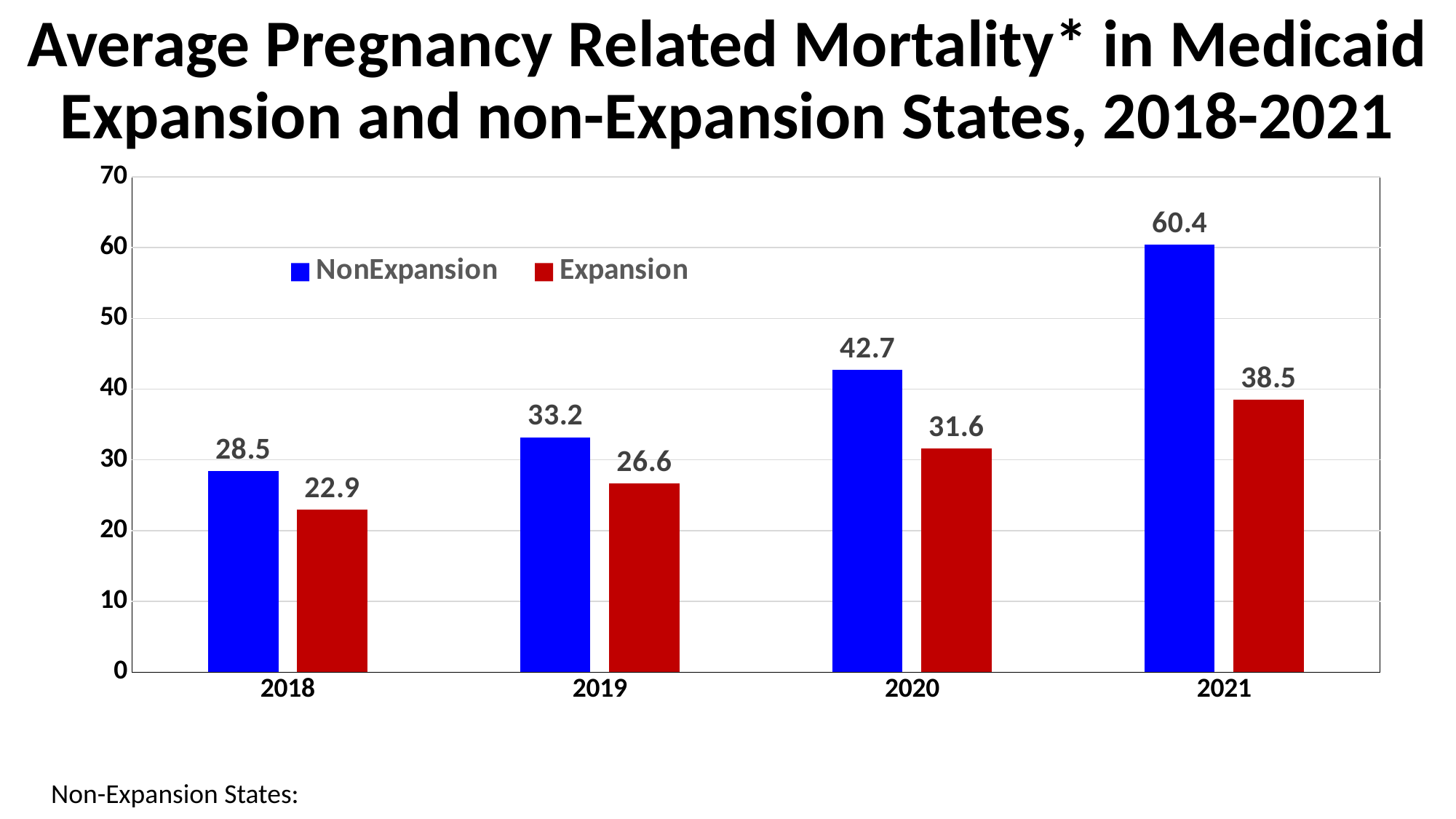
Do the Expansion values rise or fall from 2018 to 2021? Rise What is the Expansion value for 2020? 31.6 What is the Expansion value for 2018? 22.9 What is the NonExpansion value for 2021? 60.4 How many years are shown on the x axis? 4 Which year has the highest NonExpansion value? 2021 Which year has the lowest Expansion value? 2018 What is the difference between the NonExpansion values for 2020 and 2019? 9.5 Which is larger in 2019, the NonExpansion value or the Expansion value? NonExpansion How many series does the legend list? 2 What kind of chart is shown on the slide? Bar chart What is the difference between the NonExpansion and Expansion values in 2021? 21.9